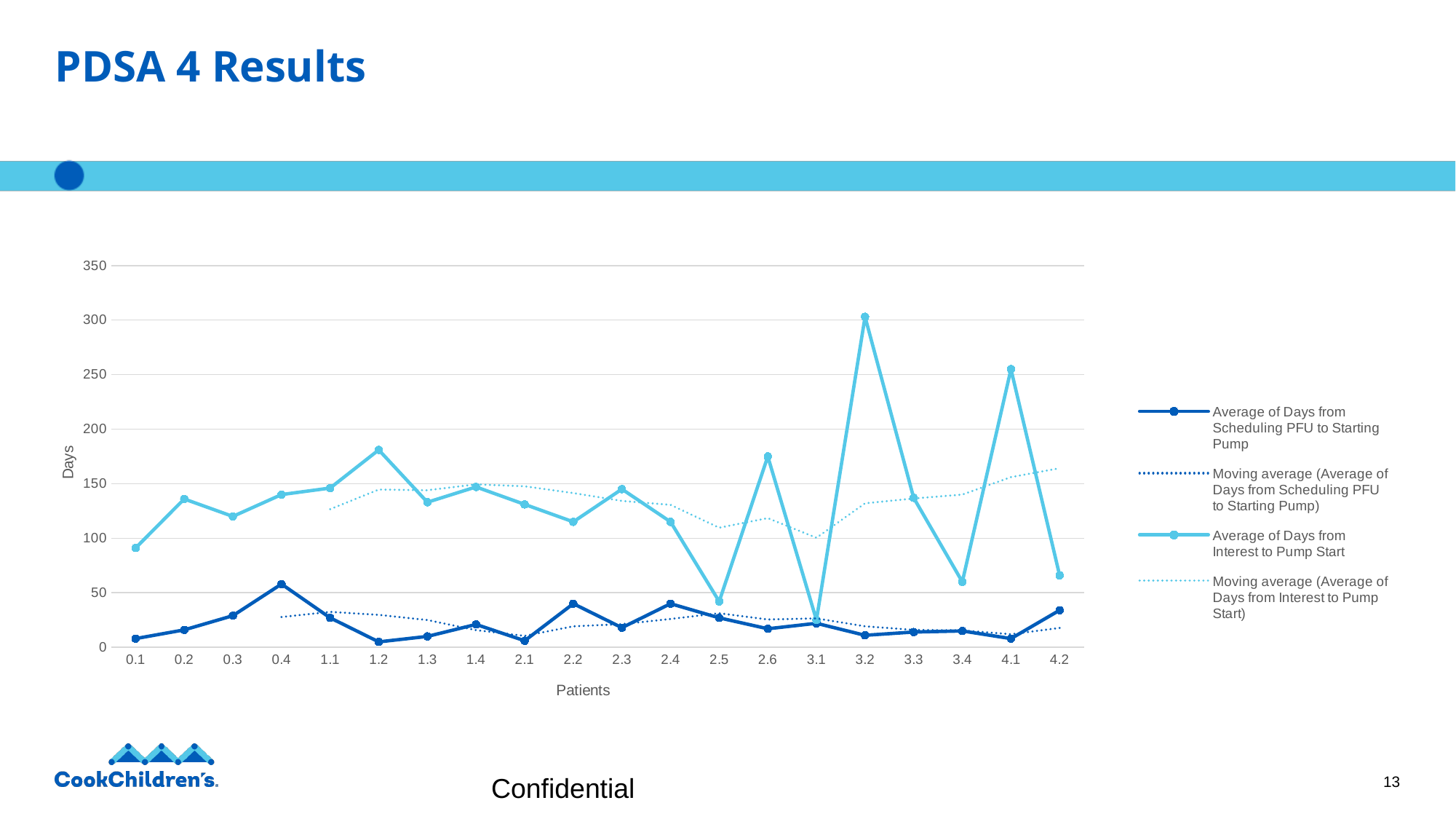
For patient 0.4, which is larger: the Average of Days from Scheduling PFU to Starting Pump or the Average of Days from Interest to Pump Start? Average of Days from Interest to Pump Start What kind of chart is shown on the slide? Line chart For which patient is the Average of Days from Interest to Pump Start lowest? 3.1 For which patient is the Average of Days from Scheduling PFU to Starting Pump highest? 0.4 Is the Average of Days from Interest to Pump Start for patient 2.5 greater or less than 50? less Is the Average of Days from Interest to Pump Start for patient 4.1 greater or less than 200? greater Does the Average of Days from Interest to Pump Start rise or fall from patient 3.2 to patient 3.4? Fall How many series does the legend list? 4 Is the Average of Days from Interest to Pump Start for patient 3.2 greater or less than 250? greater For which patient is the Average of Days from Interest to Pump Start highest? 3.2 How many patient categories are plotted along the x axis? 20 What is the label on the vertical axis of the chart? Days